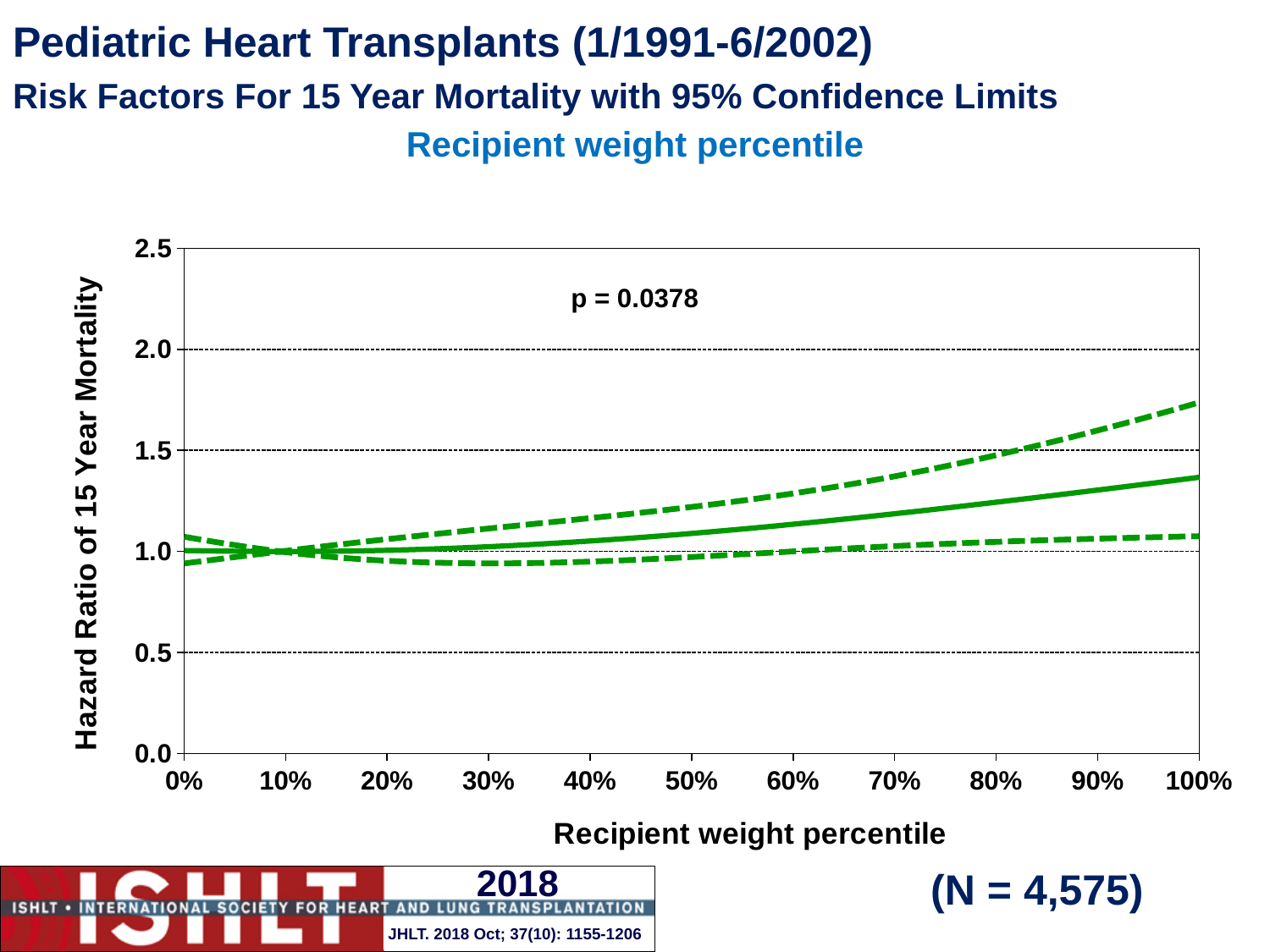
Is the value of the solid hazard ratio line at 100% recipient weight percentile greater or less than 1.5? less What sample size (N) is shown on the slide? N = 4,575 At 100% recipient weight percentile, which is larger: the upper dashed confidence limit or the solid hazard ratio line? the upper dashed confidence limit How many labelled tick marks are on the x axis? 11 Is the upper dashed confidence limit at 100% recipient weight percentile greater or less than 2.0? less What p-value is printed on the chart? p = 0.0378 What kind of chart is shown on the slide? line chart Is the upper dashed confidence limit at 100% recipient weight percentile greater or less than 1.5? greater At which recipient weight percentile does the solid hazard ratio line reach its highest value? 100% Does the solid hazard ratio line rise or fall as recipient weight percentile increases from 0% to 100%? rises